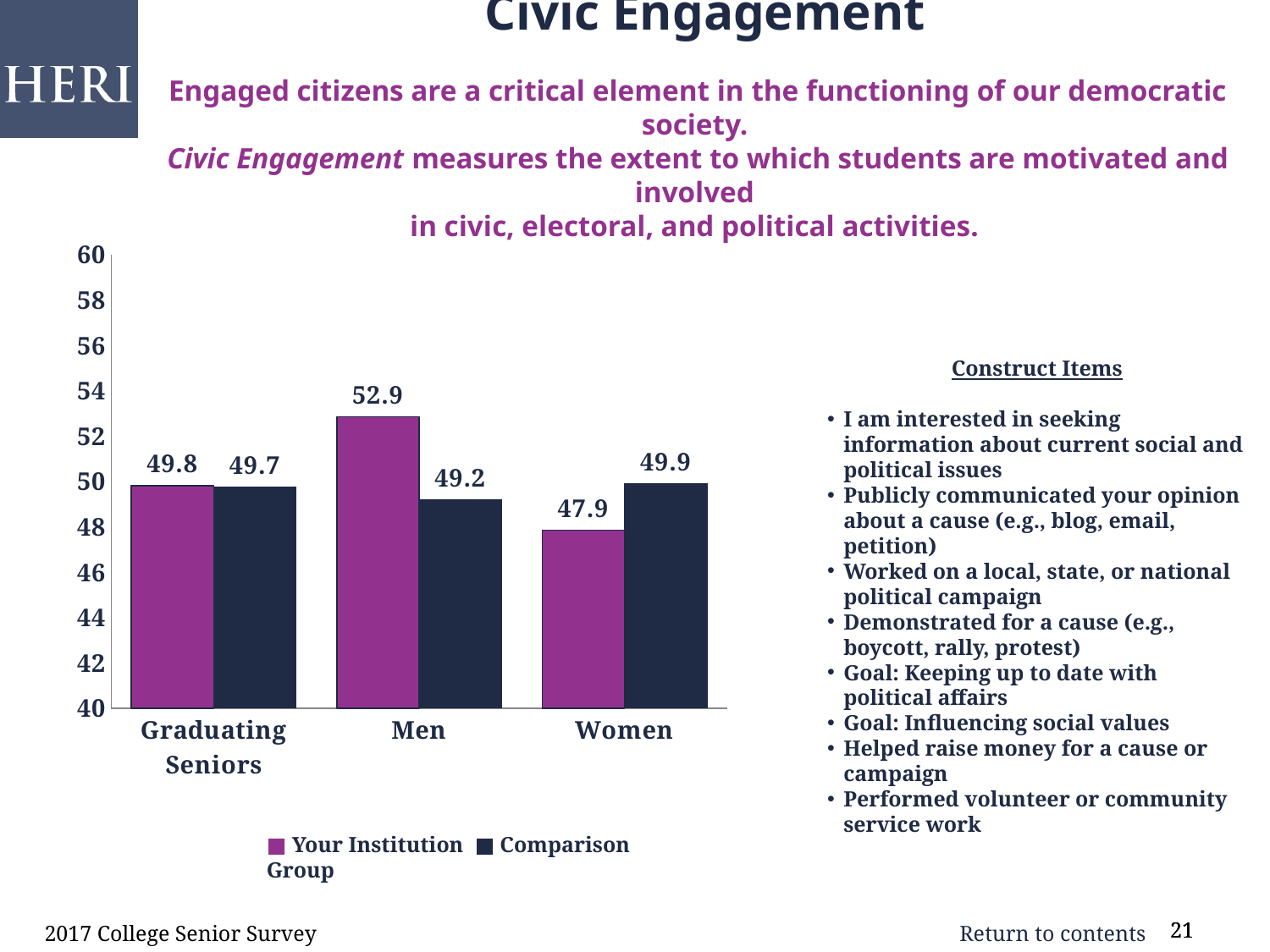
For Women, which is larger: Your Institution or Comparison Group? Comparison Group What is the Your Institution value for Men? 52.9 What is the Your Institution value for Graduating Seniors? 49.8 What is the difference between the Your Institution and Comparison Group values for Men? 3.7 How many series does the legend list? 2 Is the Your Institution value for Women greater or less than 48? less Which category has the highest Your Institution value? Men Which category has the lowest Your Institution value? Women What kind of chart is shown on the slide? bar chart What is the Comparison Group value for Women? 49.9 How many categories are shown on the x axis? 3 What is the difference between the Comparison Group and Your Institution values for Women? 2.0